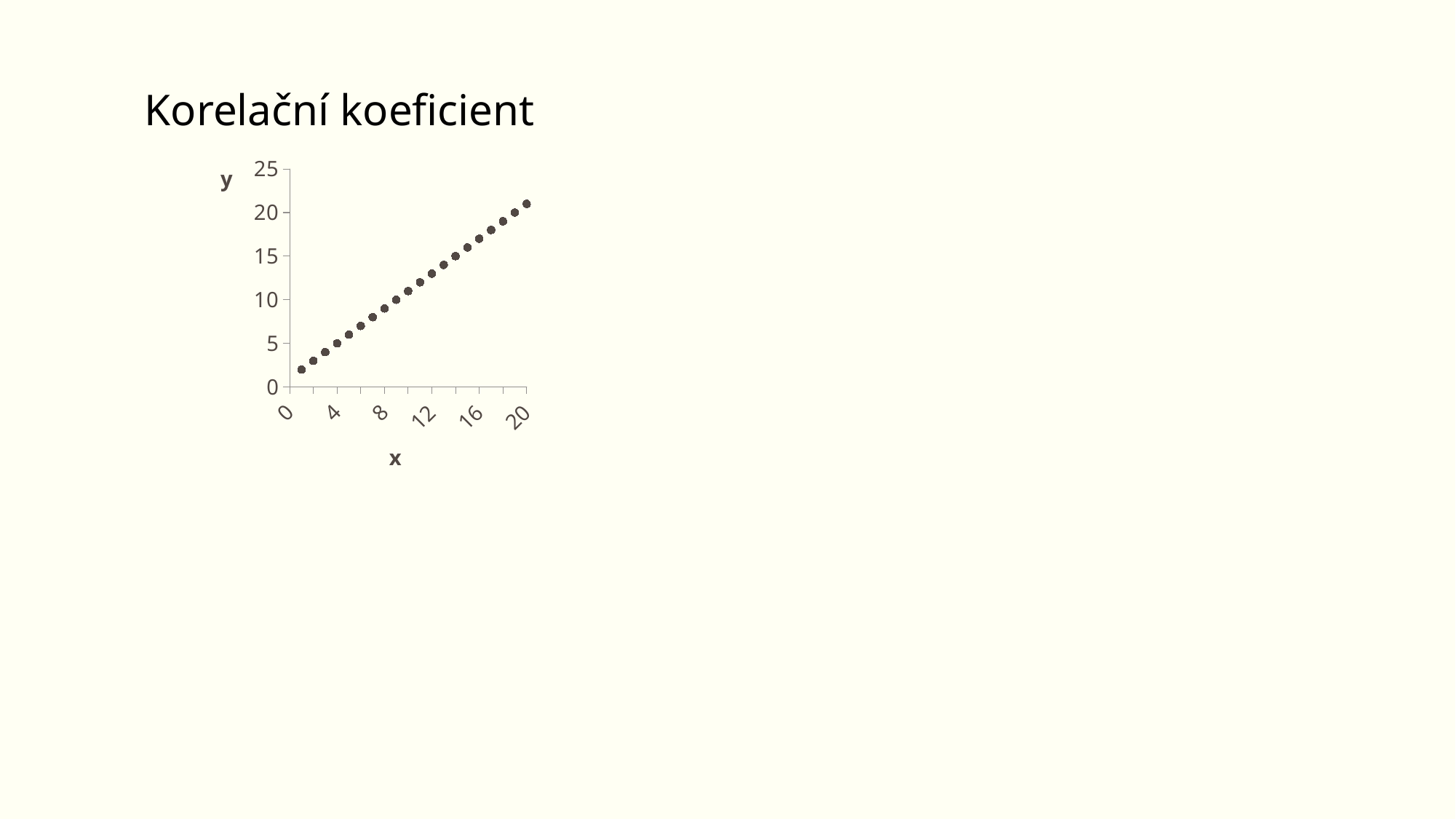
Do the y values rise or fall as x increases along the x axis? rise Is the y value of the point at x = 20 greater or less than 15? greater Is the y value of the point at x = 16 greater or less than 15? greater Which point has a larger y value, the one at x = 4 or the one at x = 16? x = 16 Is the y value of the point at x = 4 greater or less than 10? less What kind of chart is shown on the slide? scatter chart What is the title of the slide containing the chart? Korelační koeficient At which x value does the chart reach its highest y value? 20 How many data points are plotted on the chart? 20 What are the labels of the horizontal and vertical axes? x and y